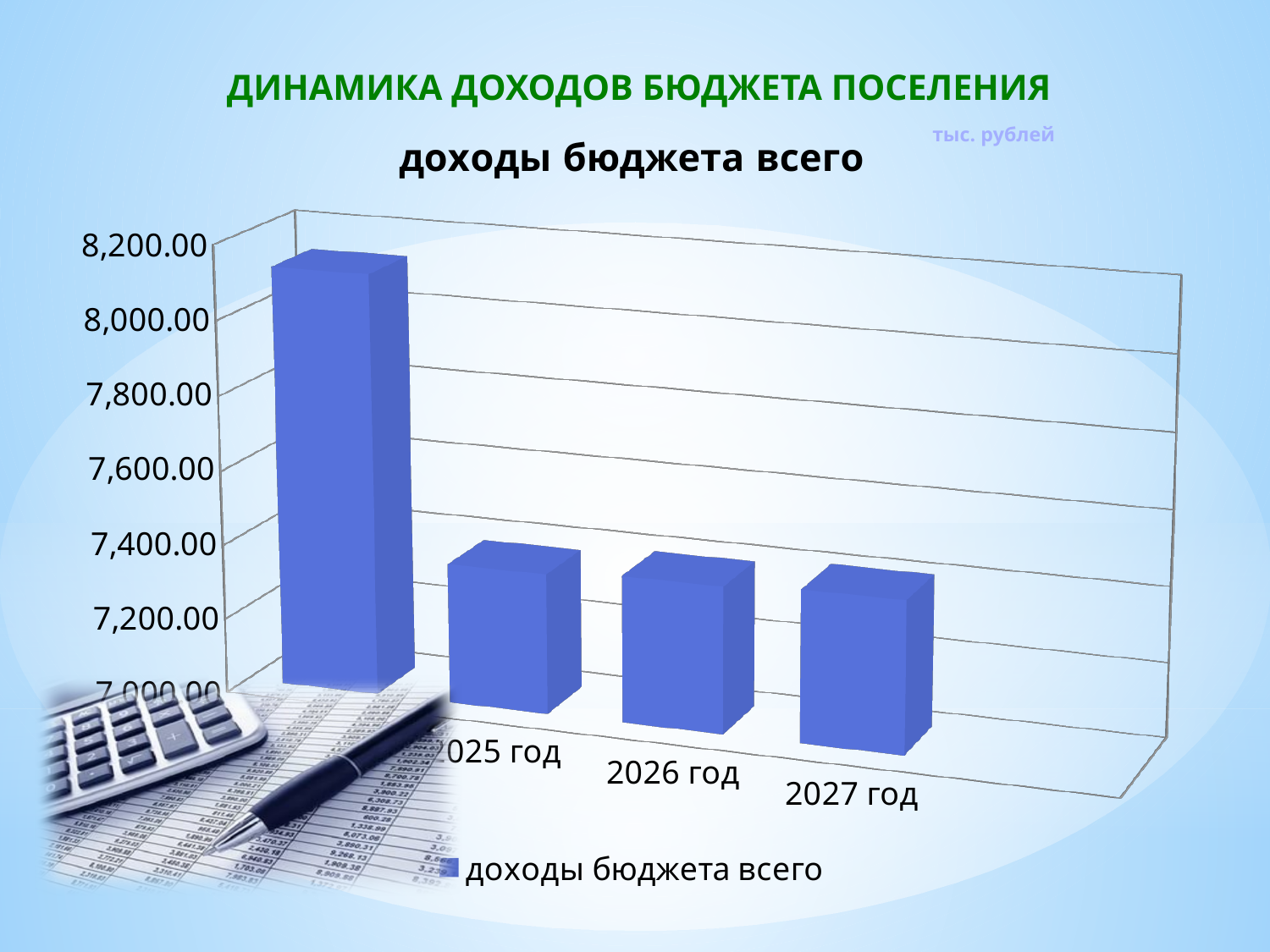
How many bars are plotted in the chart? 4 Is the value for the first (leftmost) bar greater or less than 8,000.00? greater How many series does the legend list? 1 What kind of chart is shown on the slide? bar chart What is the title of the chart? доходы бюджета всего Is the value for 2025 год greater or less than 7,200.00? greater What unit is indicated for the chart values? тыс. рублей Is the value for 2025 год greater or less than 7,400.00? less